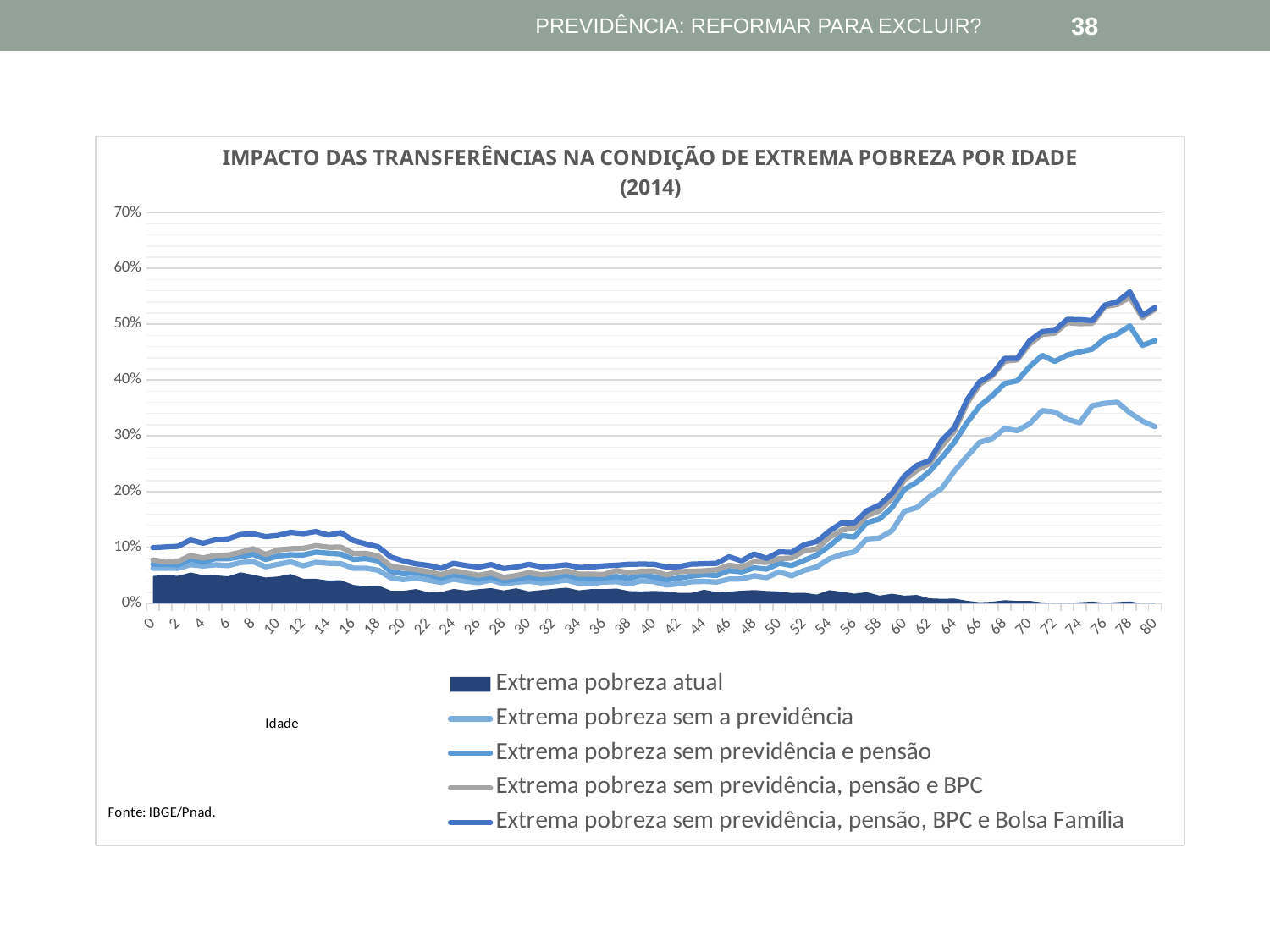
Is the value for 'Extrema pobreza sem previdência, pensão, BPC e Bolsa Família' at age 78 greater or less than 50%? greater Does 'Extrema pobreza sem a previdência' rise or fall between ages 60 and 70? rise At age 70, which is higher: 'Extrema pobreza atual' or 'Extrema pobreza sem a previdência'? Extrema pobreza sem a previdência Which series has the lowest value at age 70? Extrema pobreza atual What year is given in the chart title? 2014 At age 80, which is higher: 'Extrema pobreza sem a previdência' or 'Extrema pobreza sem previdência e pensão'? Extrema pobreza sem previdência e pensão Is the value for 'Extrema pobreza atual' at age 0 greater or less than 10%? less Is the value for 'Extrema pobreza sem a previdência' at age 76 greater or less than 30%? greater Does 'Extrema pobreza atual' rise or fall between ages 50 and 80? fall What kind of chart is shown on the slide? combination area and line chart How many series does the legend list? 5 What source is cited for the chart? IBGE/Pnad